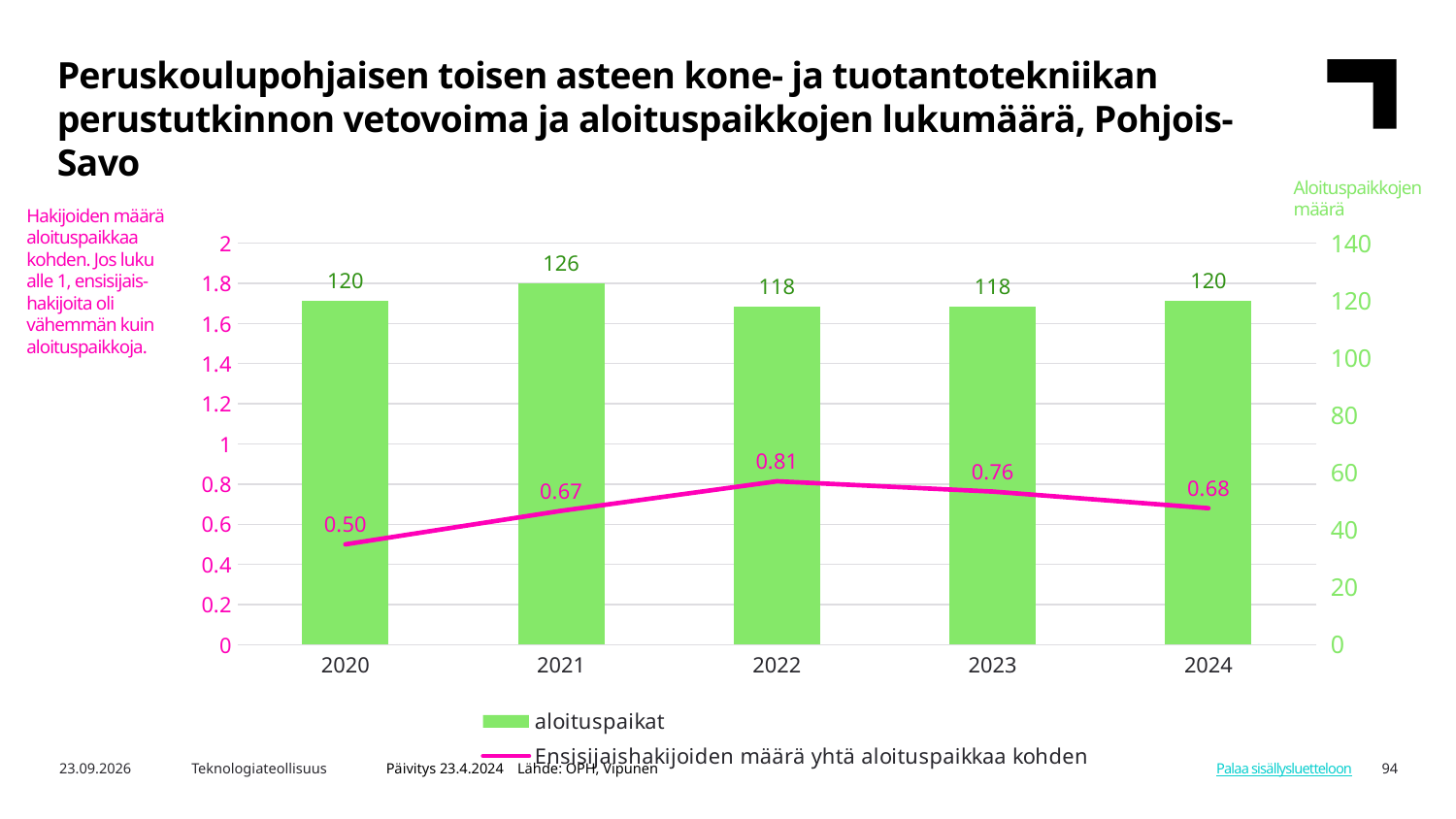
How many series does the legend list? 2 What is the value of aloituspaikat for 2024? 120 Which year has the highest aloituspaikat value? 2021 In which year is the Ensisijaishakijoiden määrä yhtä aloituspaikkaa kohden line at its highest? 2022 What is the value of Ensisijaishakijoiden määrä yhtä aloituspaikkaa kohden for 2022? 0.81 Does the Ensisijaishakijoiden määrä yhtä aloituspaikkaa kohden line rise or fall from 2020 to 2022? rise What is the difference between the aloituspaikat values for 2021 and 2022? 8 What is the difference between the Ensisijaishakijoiden määrä yhtä aloituspaikkaa kohden values for 2022 and 2020? 0.31 How many years are shown on the x axis? 5 In which year is the Ensisijaishakijoiden määrä yhtä aloituspaikkaa kohden line at its lowest? 2020 Which is larger, the Ensisijaishakijoiden määrä yhtä aloituspaikkaa kohden value for 2023 or for 2024? 2023 What is the value of aloituspaikat for 2021? 126